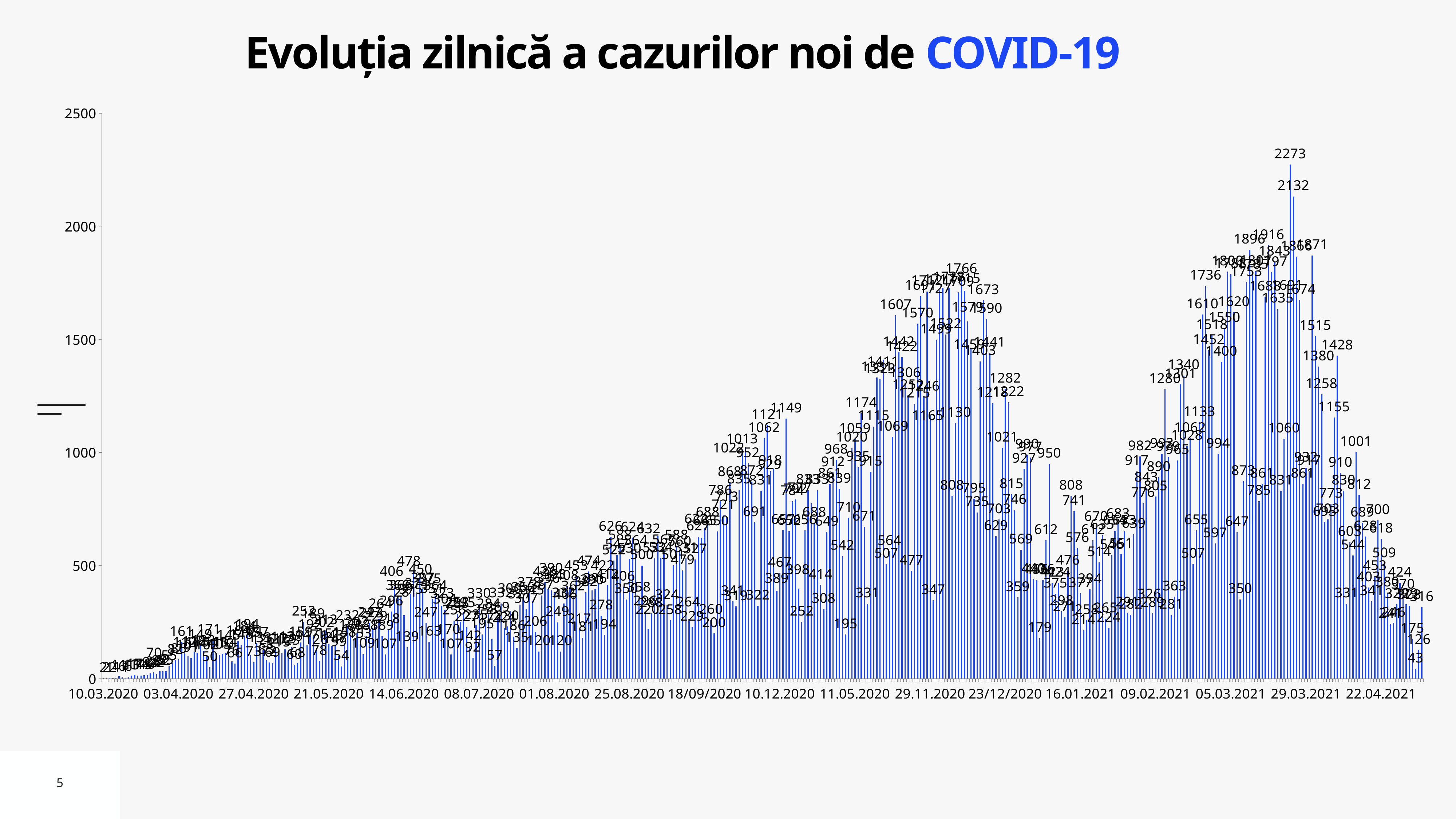
What is the first date label on the x axis? 10.03.2020 What is the value of the rightmost (last) bar on the chart? 316 Is the highest bar on the chart greater or less than 2000? greater How many date labels are shown on the x axis? 18 What kind of chart is shown on the slide? bar chart Is the value of the rightmost bar greater or less than 500? less What is the title of the chart? Evoluția zilnică a cazurilor noi de COVID-19 What is the difference between the two highest labeled values, 2273 and 2132? 141 What is the maximum value shown on the y axis? 2500 Which is larger, the highest peak of the 2021 wave (2273) or the highest peak of the late-2020 wave (1766)? 2273 Do the values generally rise or fall between 10.03.2020 and 03.04.2020? rise What is the highest value labeled on the chart? 2273